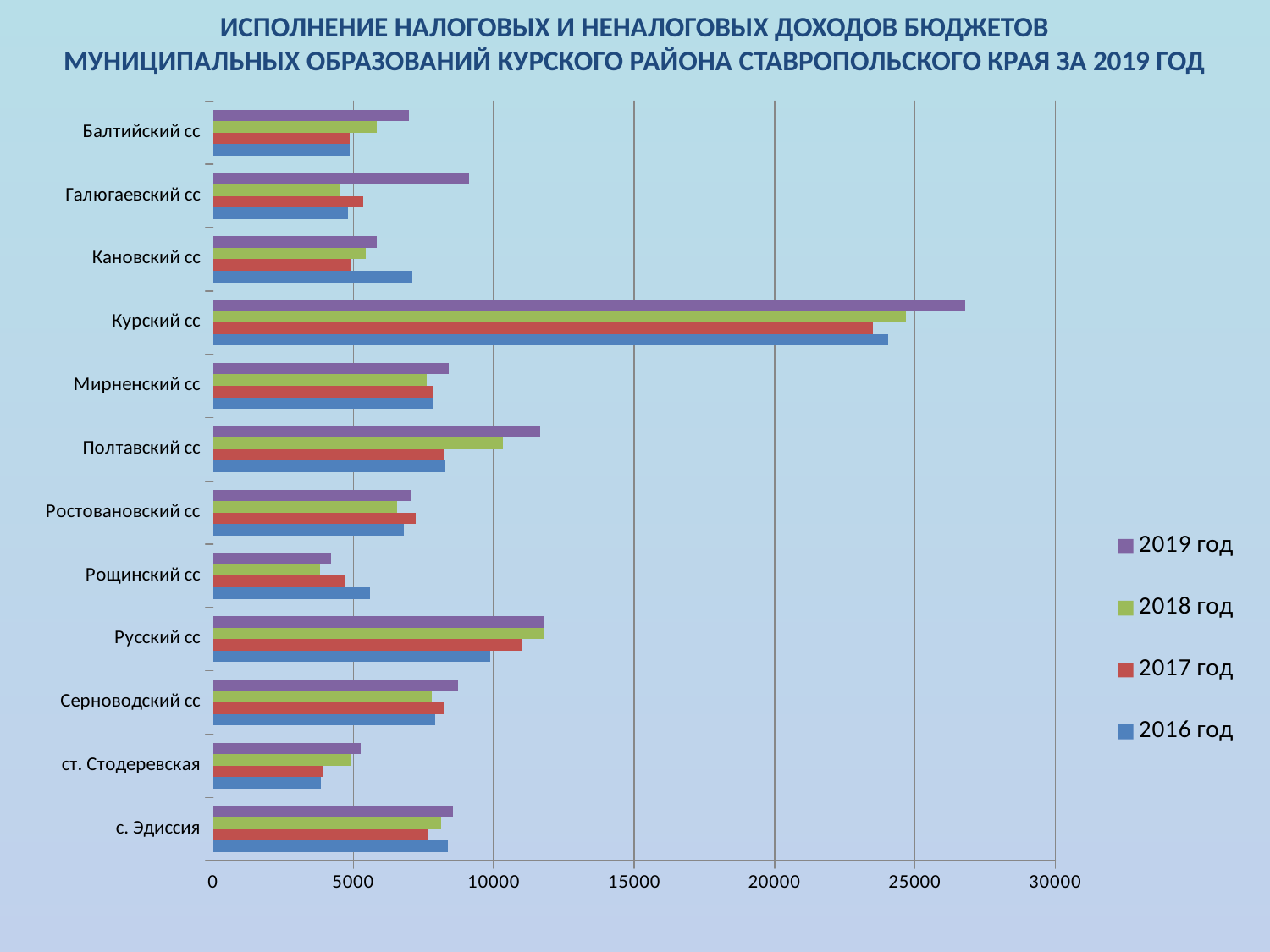
What kind of chart is shown on the slide? Bar chart Which municipality has the lowest value for 2016 год? ст. Стодеревская Is the 2019 год value for Рощинский сс greater or less than 5000? less How many series does the legend list? 4 Which years are listed in the legend? 2019 год, 2018 год, 2017 год, 2016 год How many municipalities (categories) are listed on the vertical axis? 12 Which municipality has the highest value for 2019 год? Курский сс Is the 2019 год value for Курский сс greater or less than 25000? greater Which municipality has the lowest value for 2019 год? Рощинский сс Is the 2019 год value for Полтавский сс greater or less than 10000? greater For Курский сс, which is larger: the value for 2019 год or for 2017 год? 2019 год For Рощинский сс, which is larger: the value for 2016 год or for 2019 год? 2016 год